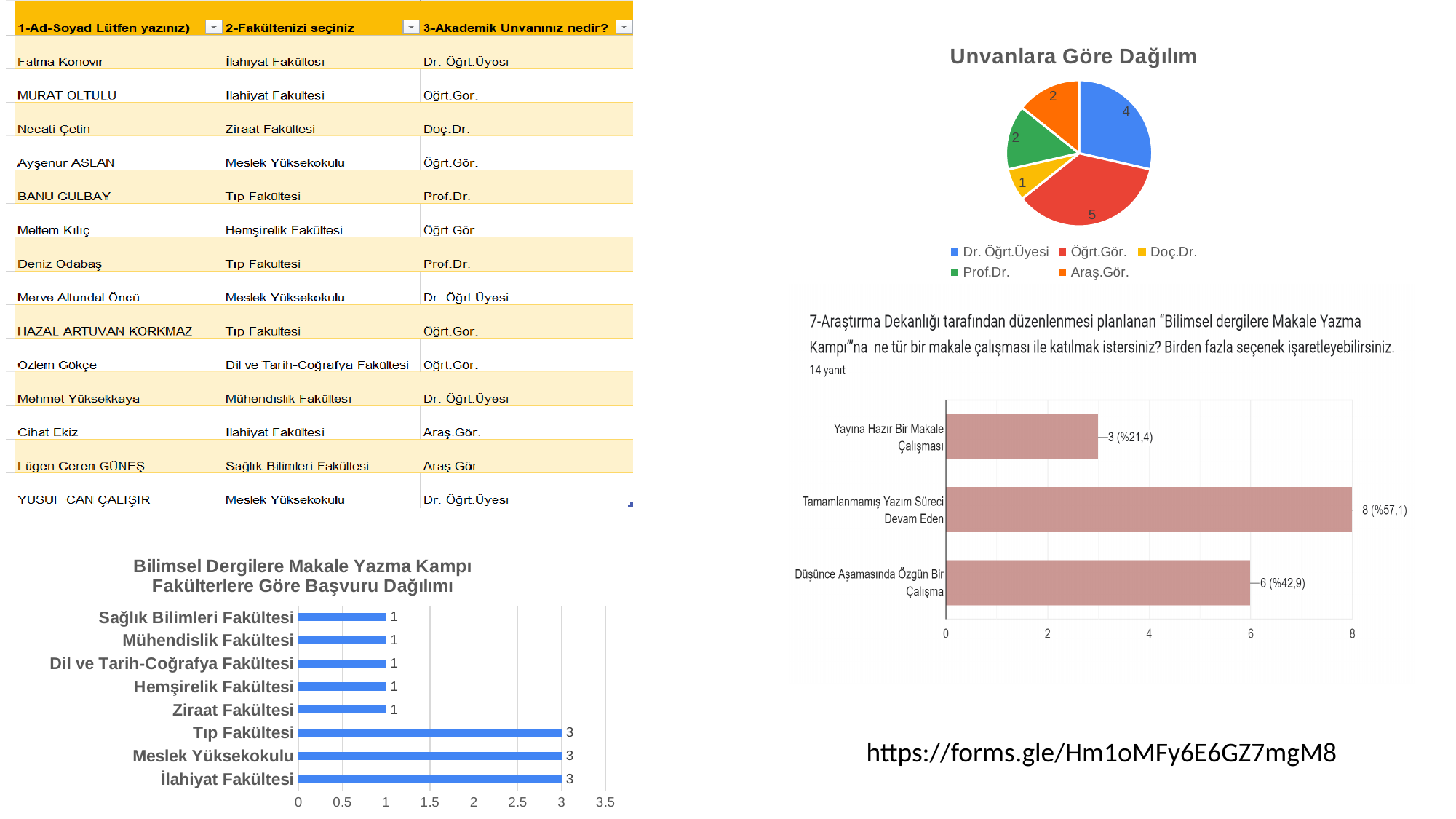
What type of chart is 'Bilimsel Dergilere Makale Yazma Kampı Fakülterlere Göre Başvuru Dağılımı'? Bar chart In the chart 'Bilimsel Dergilere Makale Yazma Kampı Fakülterlere Göre Başvuru Dağılımı', which is larger: Meslek Yüksekokulu or Ziraat Fakültesi? Meslek Yüksekokulu In the pie chart 'Unvanlara Göre Dağılım', what is the value for Öğrt.Gör.? 5 In the pie chart 'Unvanlara Göre Dağılım', which title has the smallest slice? Doç.Dr. In the chart 'Bilimsel Dergilere Makale Yazma Kampı Fakülterlere Göre Başvuru Dağılımı', how many faculties are listed? 8 In the pie chart 'Unvanlara Göre Dağılım', which colour represents Prof.Dr.? Green In the pie chart 'Unvanlara Göre Dağılım', how many entries does the legend list? 5 In the pie chart 'Unvanlara Göre Dağılım', which title has the largest slice? Öğrt.Gör. In the chart 'Bilimsel Dergilere Makale Yazma Kampı Fakülterlere Göre Başvuru Dağılımı', what is the value for Tıp Fakültesi? 3 In the pie chart 'Unvanlara Göre Dağılım', what is the difference between the values for Öğrt.Gör. and Dr. Öğrt.Üyesi? 1 In the bar chart for question 7 on the right, which option has the lowest value? Yayına Hazır Bir Makale Çalışması In the bar chart for question 7 on the right, what is the value for 'Tamamlanmamış Yazım Süreci Devam Eden'? 8 (%57,1)